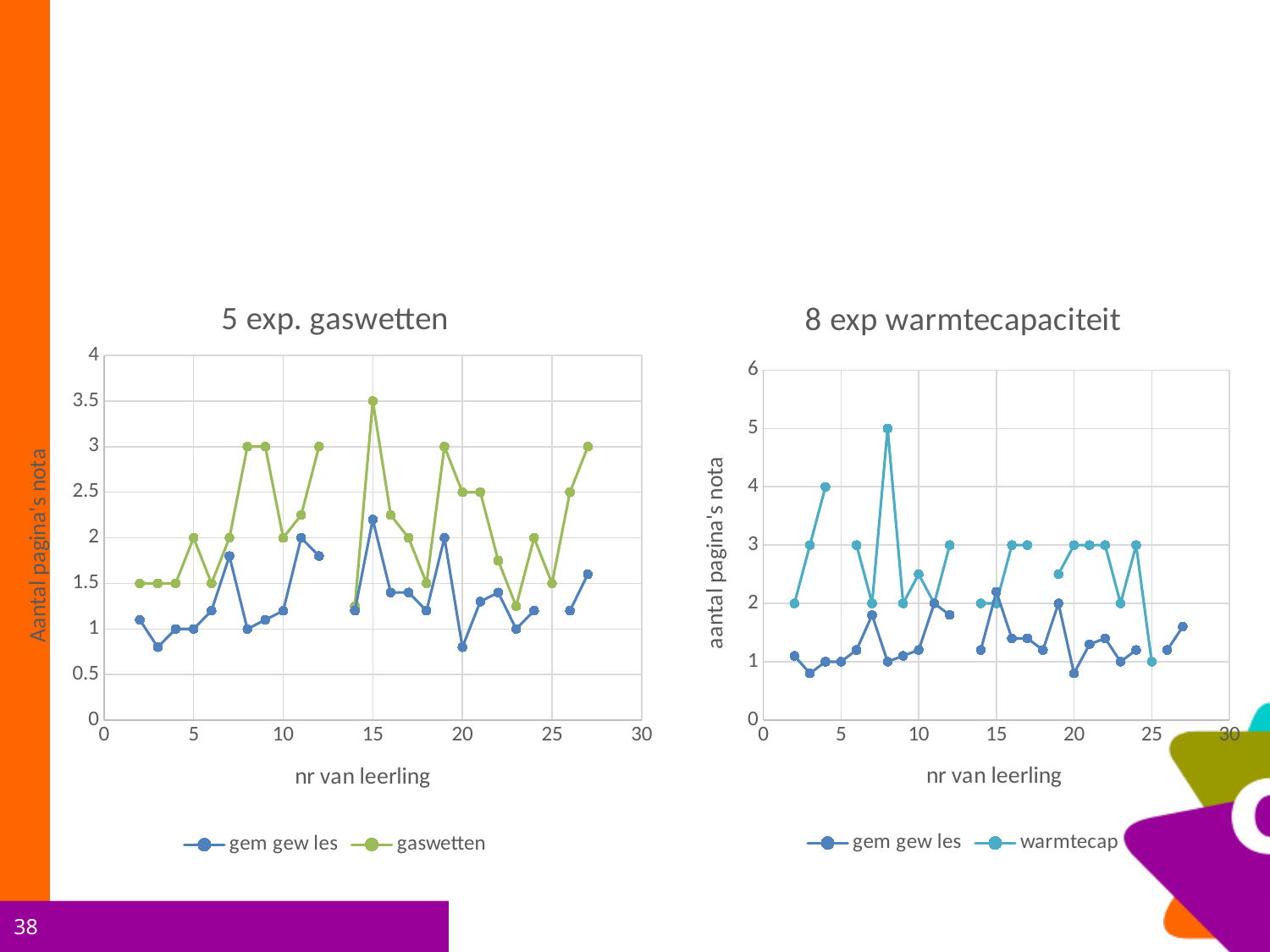
In the '8 exp warmtecapaciteit' chart, what is the warmtecap value at nr van leerling 4? 4 In the '8 exp warmtecapaciteit' chart, what is the warmtecap value at nr van leerling 8? 5 In the '5 exp. gaswetten' chart, is the gem gew les value at nr van leerling 20 greater or less than 1? less In the '5 exp. gaswetten' chart, what is the highest value of the gaswetten series? 3.5 In the '5 exp. gaswetten' chart, at which nr van leerling is the gaswetten series highest? 15 In the '8 exp warmtecapaciteit' chart, at nr van leerling 8, which series has the larger value, gem gew les or warmtecap? warmtecap What kind of chart is the '5 exp. gaswetten' chart? line chart In the '8 exp warmtecapaciteit' chart, at which nr van leerling is the warmtecap series highest? 8 In the '5 exp. gaswetten' chart, how many series does the legend list? 2 In the '5 exp. gaswetten' chart, at nr van leerling 15, which series has the larger value, gem gew les or gaswetten? gaswetten In the '8 exp warmtecapaciteit' chart, how many series does the legend list? 2 What is the x-axis title of the '5 exp. gaswetten' chart? nr van leerling